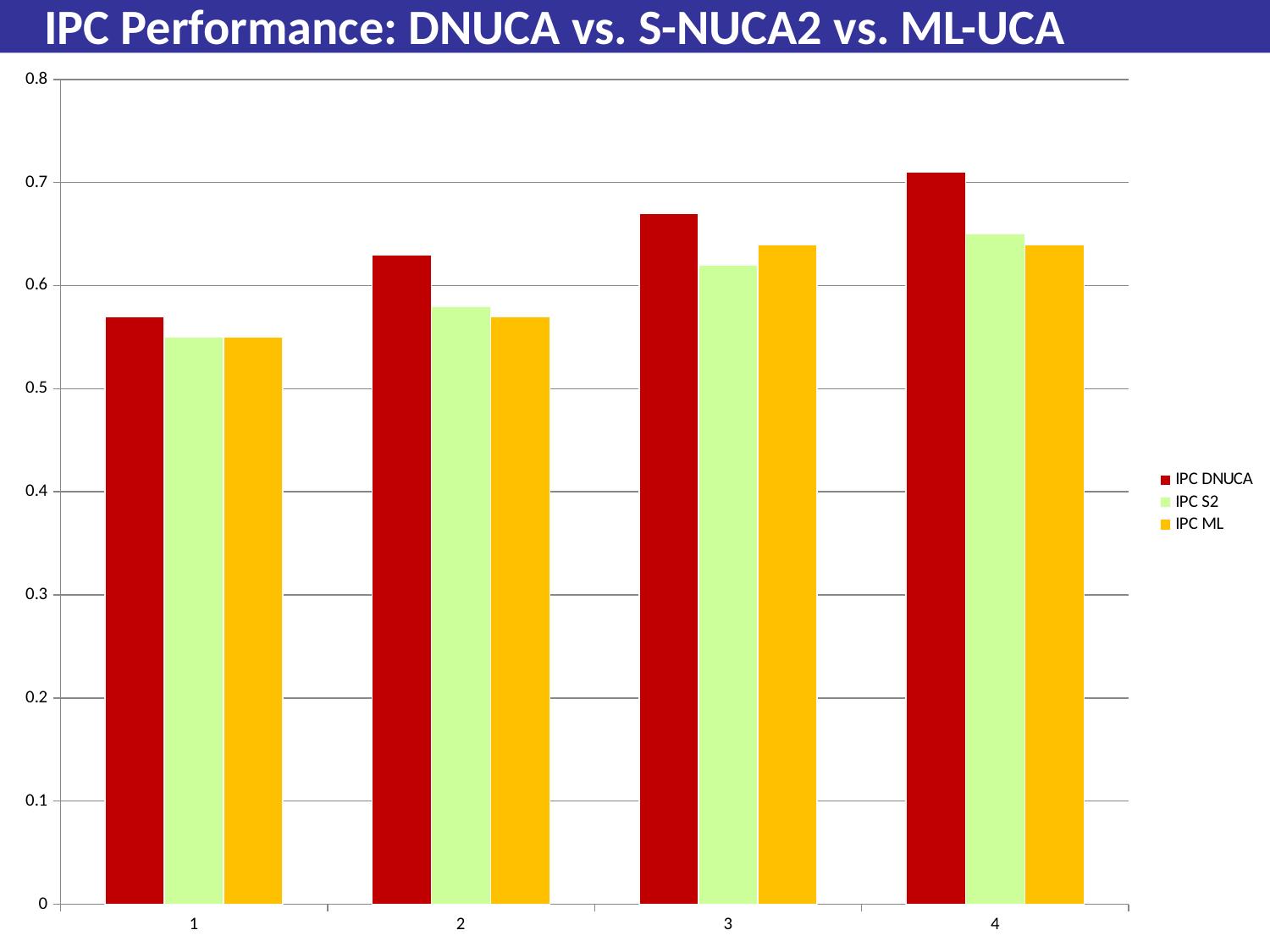
Is the IPC ML value for category 3 greater or less than 0.6? greater For category 2, which is larger: IPC DNUCA or IPC S2? IPC DNUCA Do the IPC DNUCA values rise or fall from category 1 to category 4? rise How many series does the legend list? 3 What is the title of the chart? IPC Performance: DNUCA vs. S-NUCA2 vs. ML-UCA Is the IPC DNUCA value for category 1 greater or less than 0.5? greater Is the IPC S2 value for category 2 greater or less than 0.6? less Which category has the lowest IPC DNUCA value? 1 What kind of chart is shown on the slide? bar chart How many categories are shown on the x axis? 4 Which category has the highest IPC DNUCA value? 4